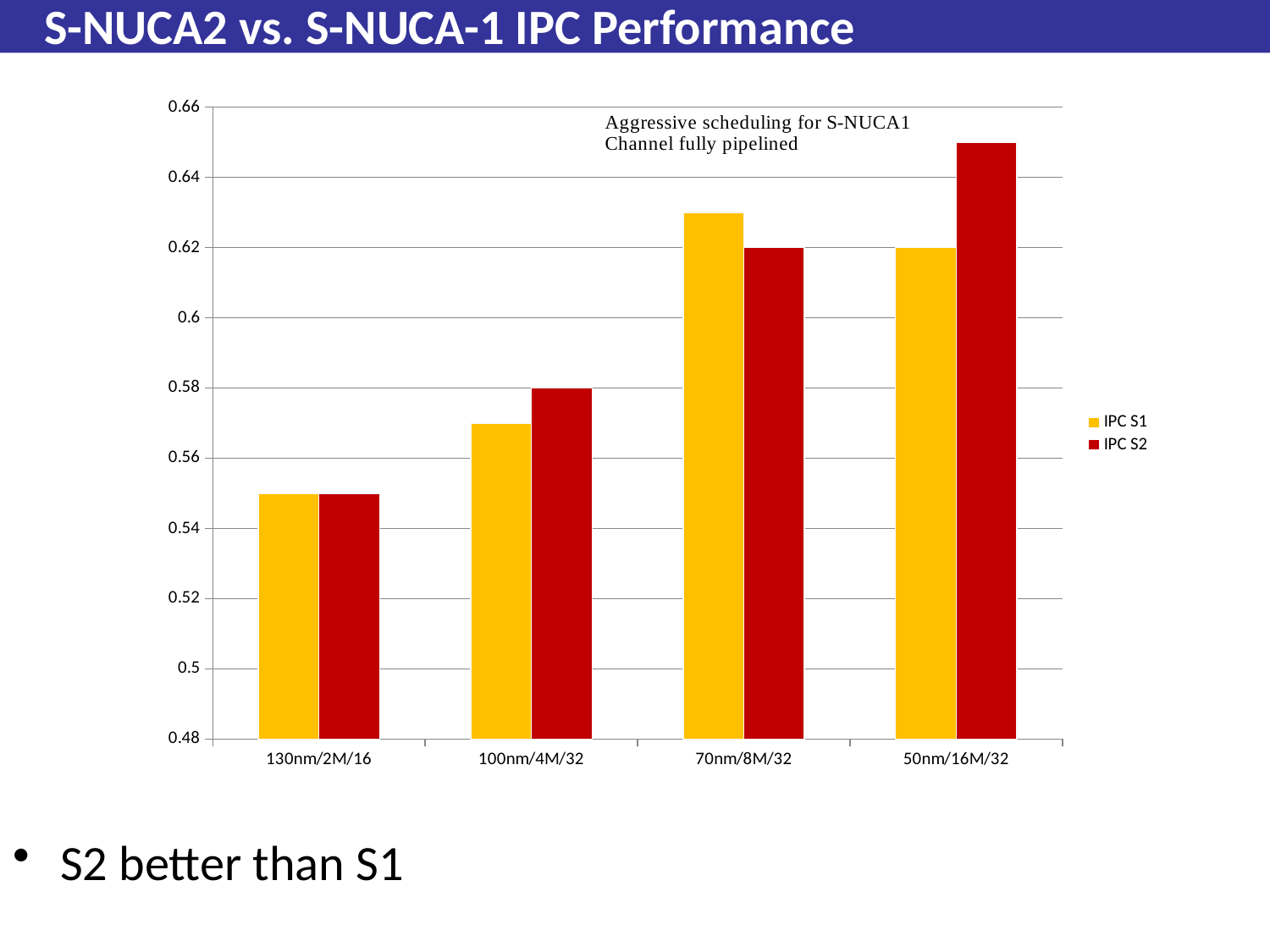
What kind of chart is shown on the slide? bar chart Is the IPC S2 value for 50nm/16M/32 greater or less than 0.64? greater Is the IPC S1 value for 130nm/2M/16 greater or less than 0.56? less For 50nm/16M/32, which is larger, IPC S1 or IPC S2? IPC S2 What is the IPC S2 value for 70nm/8M/32? 0.62 Do the IPC S2 values rise or fall from 130nm/2M/16 to 50nm/16M/32? rise What is the IPC S1 value for 50nm/16M/32? 0.62 For which category is IPC S2 highest? 50nm/16M/32 What is the IPC S2 value for 100nm/4M/32? 0.58 How many categories are shown on the x axis? 4 For which category is IPC S1 lowest? 130nm/2M/16 How many series does the legend list? 2